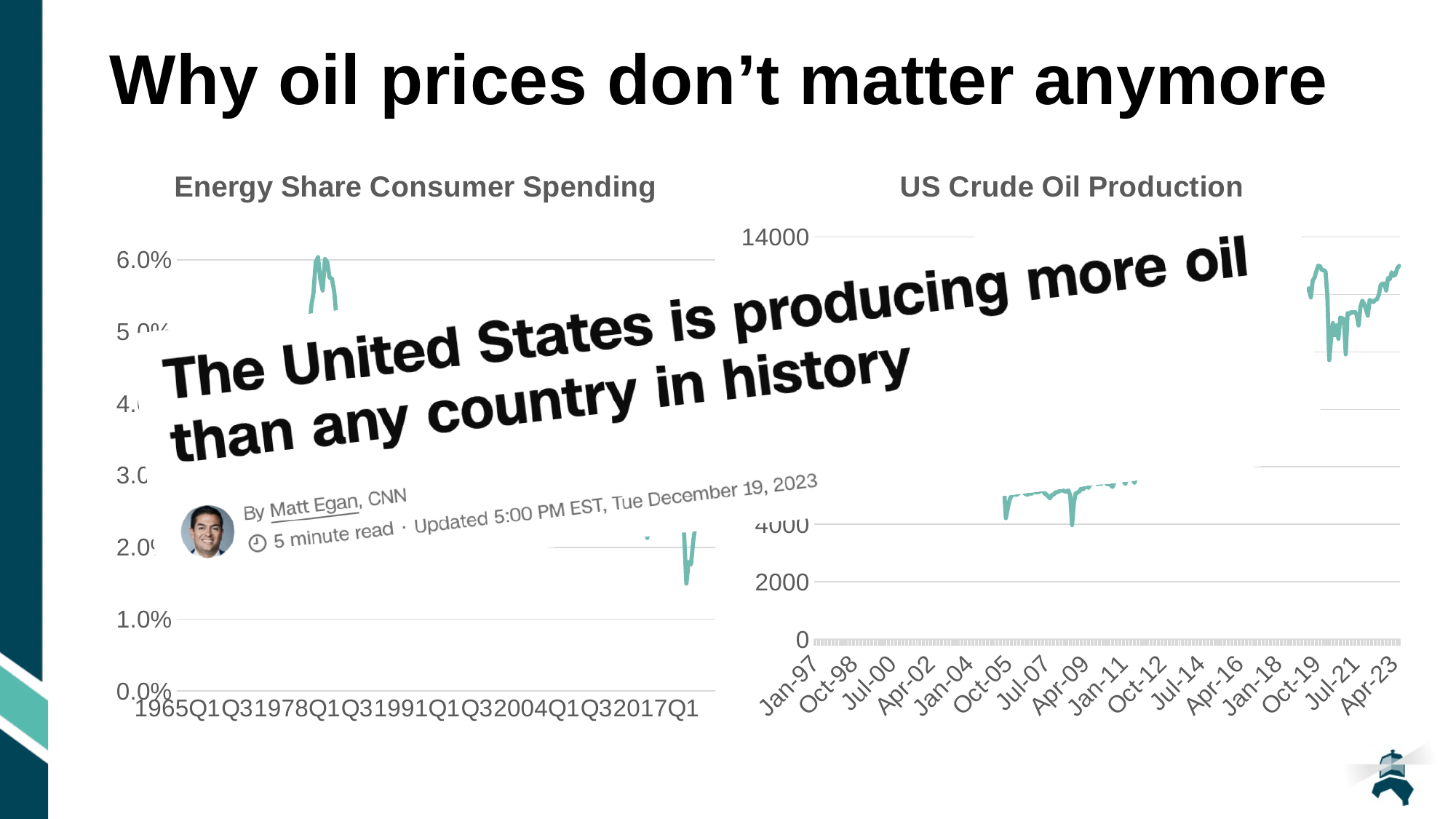
What kind of chart is the 'Energy Share Consumer Spending' chart? line chart In the 'Energy Share Consumer Spending' chart, do the values overall rise or fall from the late 1970s to the end of the series? fall In the 'Energy Share Consumer Spending' chart, is the lowest visible value near the right end of the series greater or less than 2.0%? less What kind of chart is the 'US Crude Oil Production' chart? line chart In the 'US Crude Oil Production' chart, which is larger: the value at Apr-23 or the value around Jan-11? Apr-23 What is the title of the chart on the left side of the slide? Energy Share Consumer Spending In the 'US Crude Oil Production' chart, is the value at Apr-23 greater or less than 12000? greater How many date labels are shown on the x axis of the 'US Crude Oil Production' chart? 16 In the 'Energy Share Consumer Spending' chart, is the peak value near the late 1970s greater or less than 5.0%? greater What is the highest value shown on the y axis of the 'US Crude Oil Production' chart? 14000 In the 'US Crude Oil Production' chart, do the values overall rise or fall from Jan-97 to Apr-23? rise